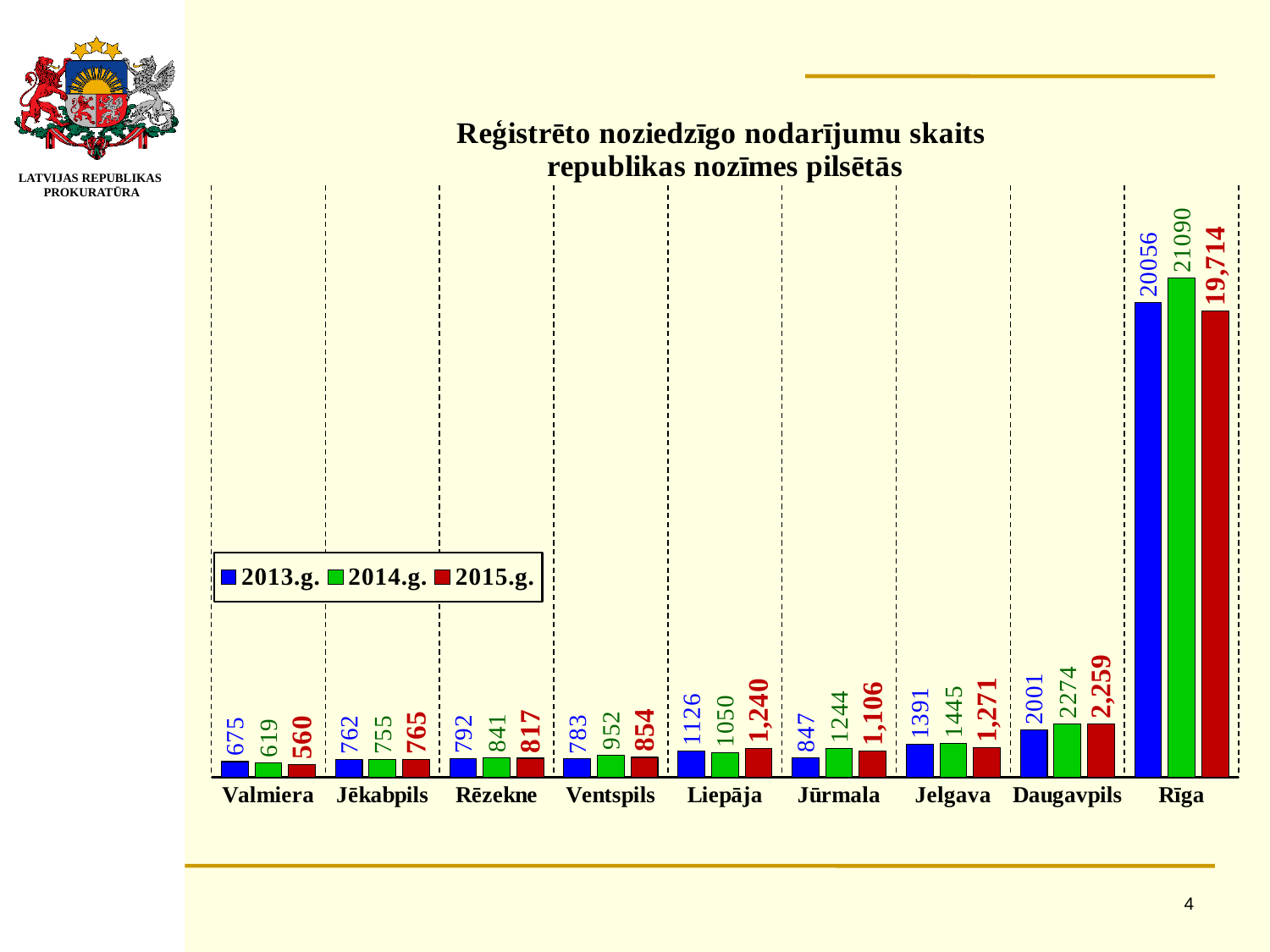
Which city has the lowest 2015.g. value? Valmiera How many series does the legend list? 3 Which city has the highest 2014.g. value? Rīga What is the 2015.g. value for Valmiera? 560 What is the 2013.g. value for Daugavpils? 2001 What is the 2014.g. value for Jūrmala? 1244 Which colour represents 2015.g. in the legend? Red Which is larger for Liepāja: the 2013.g. value or the 2014.g. value? 2013.g. What kind of chart is shown on the slide? Bar chart How many cities are shown on the x axis? 9 What is the 2015.g. value for Rīga? 19,714 What is the difference between the 2014.g. and 2013.g. values for Rīga? 1034